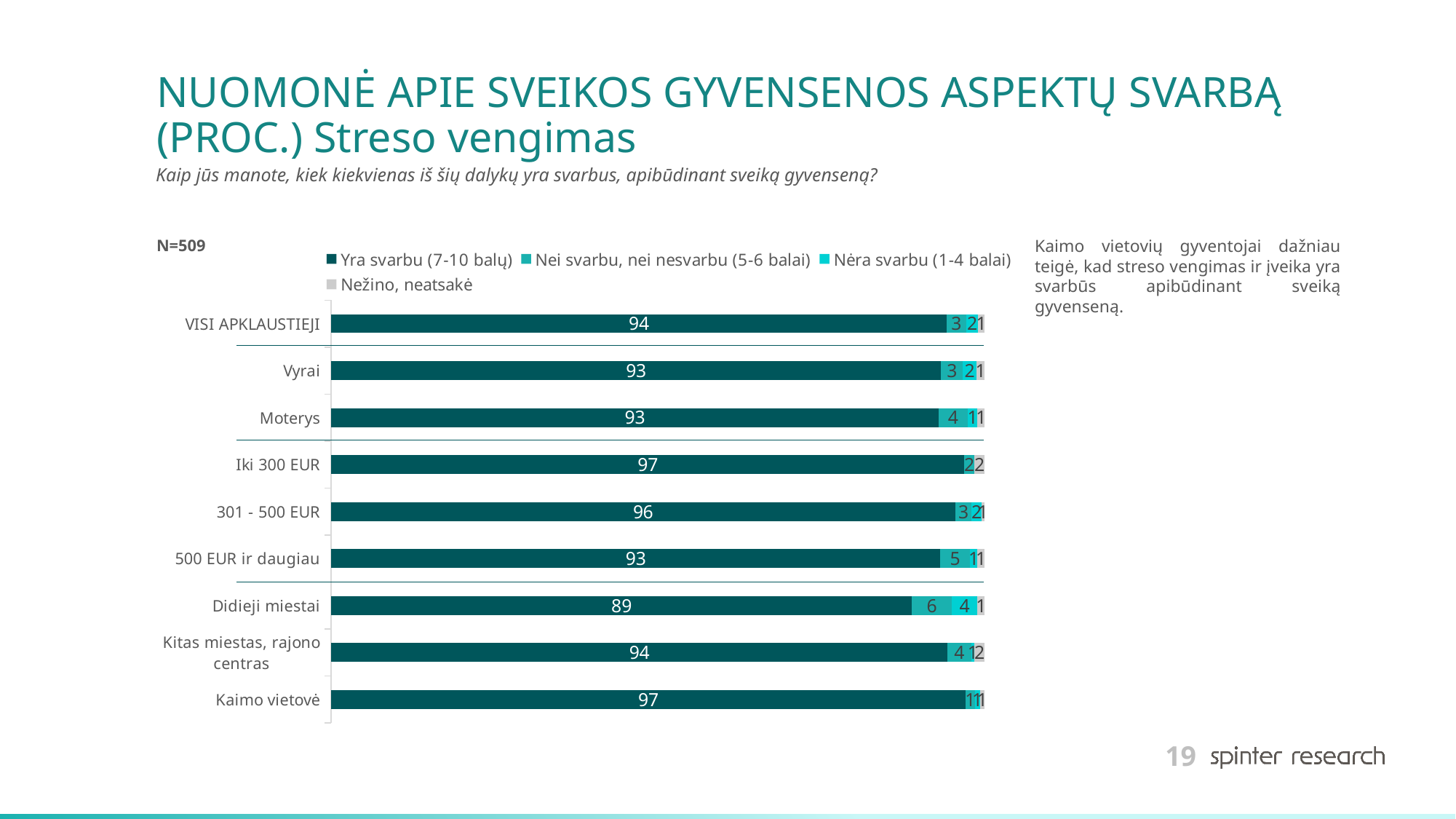
What is the value of "Nei svarbu, nei nesvarbu (5-6 balai)" for Didieji miestai? 6 Which category has the lowest value for "Yra svarbu (7-10 balų)"? Didieji miestai What is the value of "Yra svarbu (7-10 balų)" for Kaimo vietovė? 97 How many series does the legend list? 4 How many categories are plotted on the chart? 9 What is the difference between the "Yra svarbu (7-10 balų)" values for Kaimo vietovė and Didieji miestai? 8 What is the value of "Yra svarbu (7-10 balų)" for VISI APKLAUSTIEJI? 94 What is the value of "Yra svarbu (7-10 balų)" for Didieji miestai? 89 Which has a larger "Yra svarbu (7-10 balų)" value, Iki 300 EUR or 500 EUR ir daugiau? Iki 300 EUR What is the sample size (N) shown on the slide? N=509 What is the value of "Nėra svarbu (1-4 balai)" for Didieji miestai? 4 What kind of chart is shown on the slide? stacked bar chart